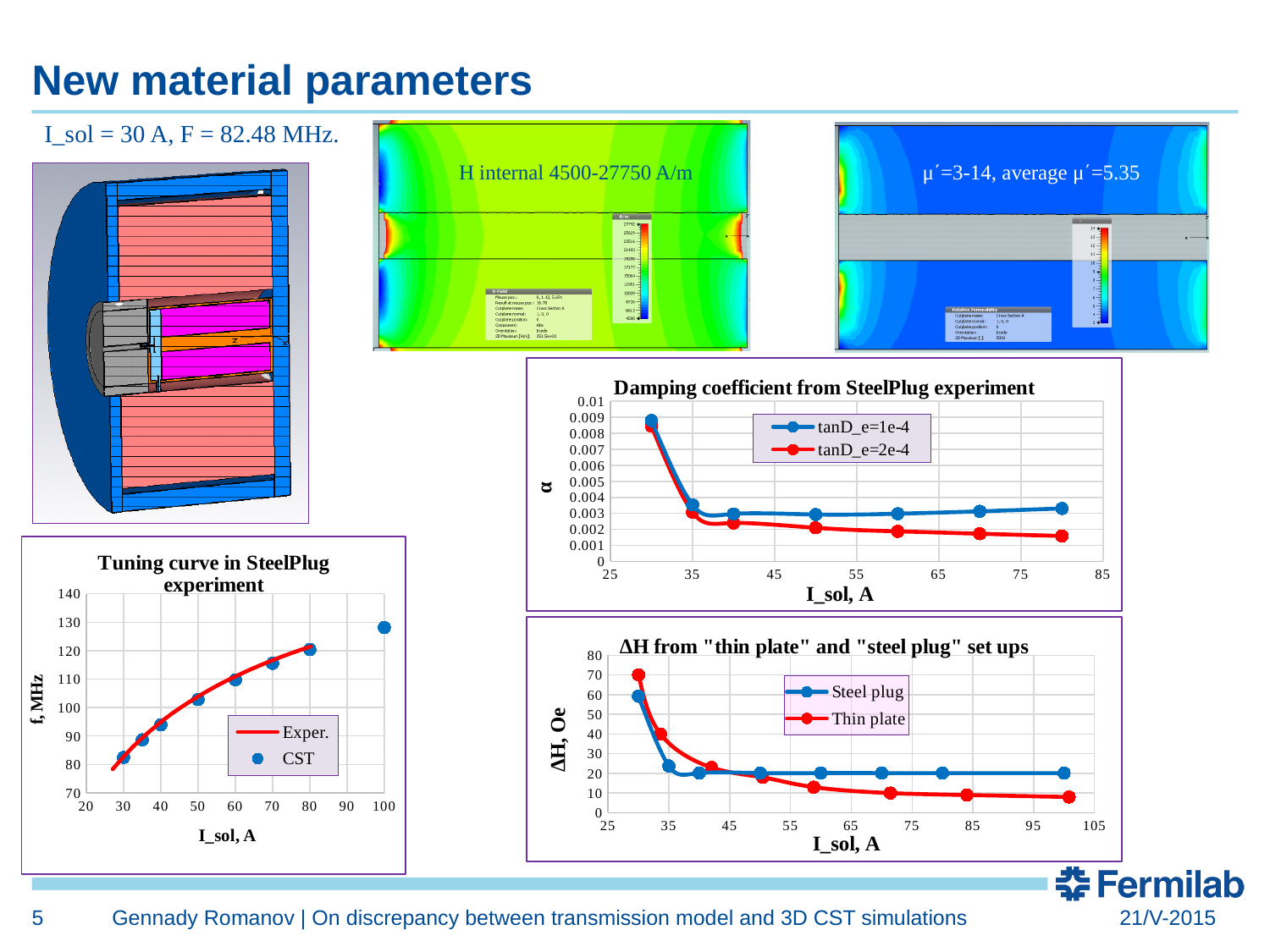
What kind of chart is the "Tuning curve in SteelPlug experiment" chart? line chart In the "Tuning curve in SteelPlug experiment" chart, does f, MHz rise or fall as I_sol increases? rise In the "ΔH from "thin plate" and "steel plug" set ups" chart, is the Thin plate value at I_sol = 30 A greater or less than 60? greater How many series does the legend of the "Tuning curve in SteelPlug experiment" chart list? 2 In the "ΔH from "thin plate" and "steel plug" set ups" chart, which series has the larger value at I_sol = 100 A, Steel plug or Thin plate? Steel plug What are the two legend entries in the "Damping coefficient from SteelPlug experiment" chart? tanD_e=1e-4 and tanD_e=2e-4 What is the y-axis label of the "ΔH from "thin plate" and "steel plug" set ups" chart? ΔH, Oe How many series does the legend of the "ΔH from "thin plate" and "steel plug" set ups" chart list? 2 In the "Tuning curve in SteelPlug experiment" chart, is the CST value at I_sol = 100 A greater or less than 120? greater In the "Damping coefficient from SteelPlug experiment" chart, which series has the larger value at I_sol = 80 A, tanD_e=1e-4 or tanD_e=2e-4? tanD_e=1e-4 In the "Damping coefficient from SteelPlug experiment" chart, does α rise or fall as I_sol increases from 30 to 35 A? fall